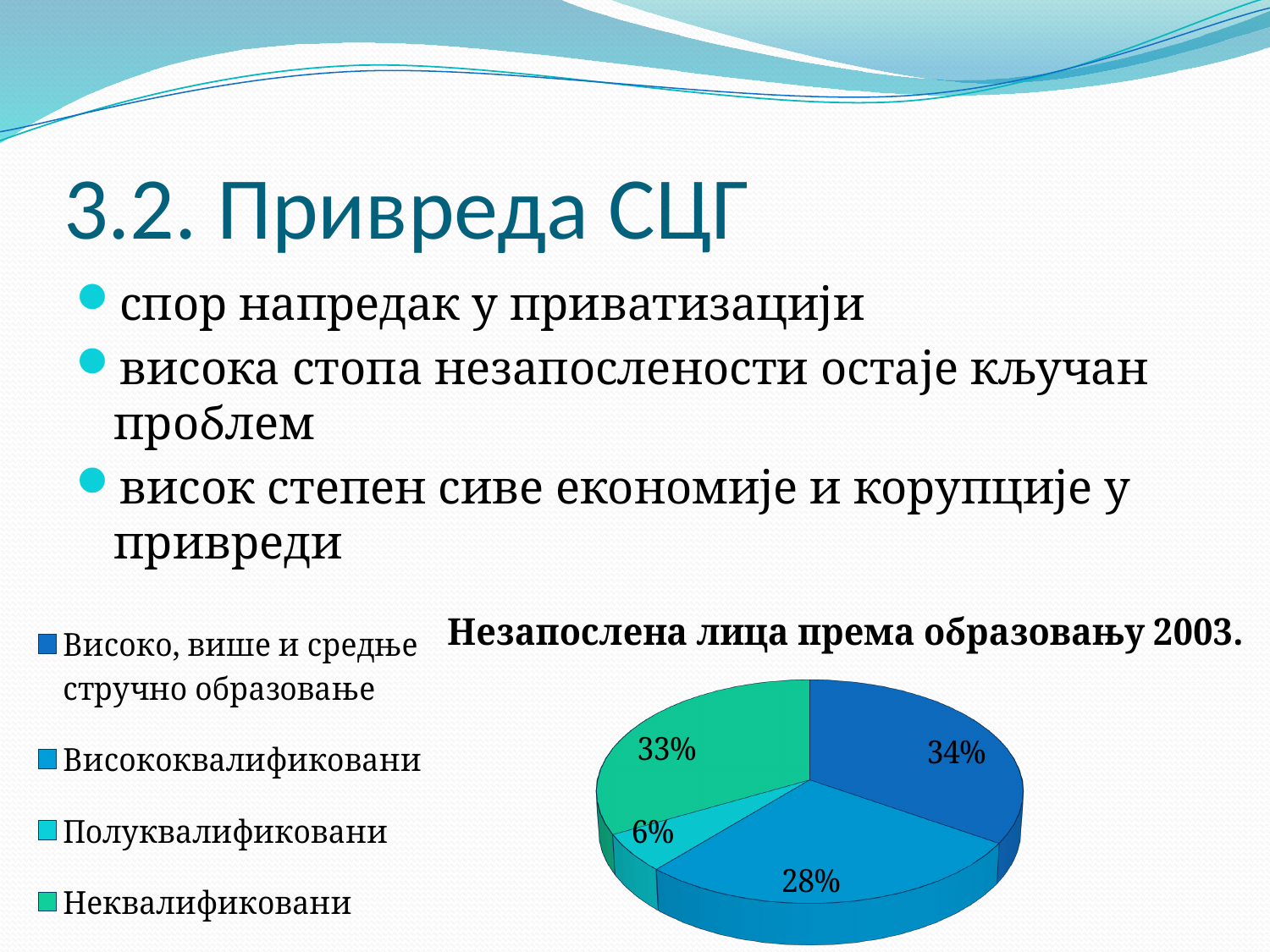
What is the difference in percentage points between Висококвалификовани and Полуквалификовани? 22 What is the title of the chart? Незапослена лица према образовању 2003. What colour is the slice for Неквалификовани? green What type of chart is shown on the slide? pie chart How many categories does the pie chart show? 4 Which is larger, the share for Висококвалификовани or the share for Неквалификовани? Неквалификовани Which category has the smallest share of the pie? Полуквалификовани What percentage of the pie is labelled for Висококвалификовани? 28% What percentage of the pie is labelled for Високо, више и средње стручно образовање? 34% Which category has the largest share of the pie? Високо, више и средње стручно образовање What percentage of the pie is labelled for Неквалификовани? 33% What percentage of the pie is labelled for Полуквалификовани? 6%